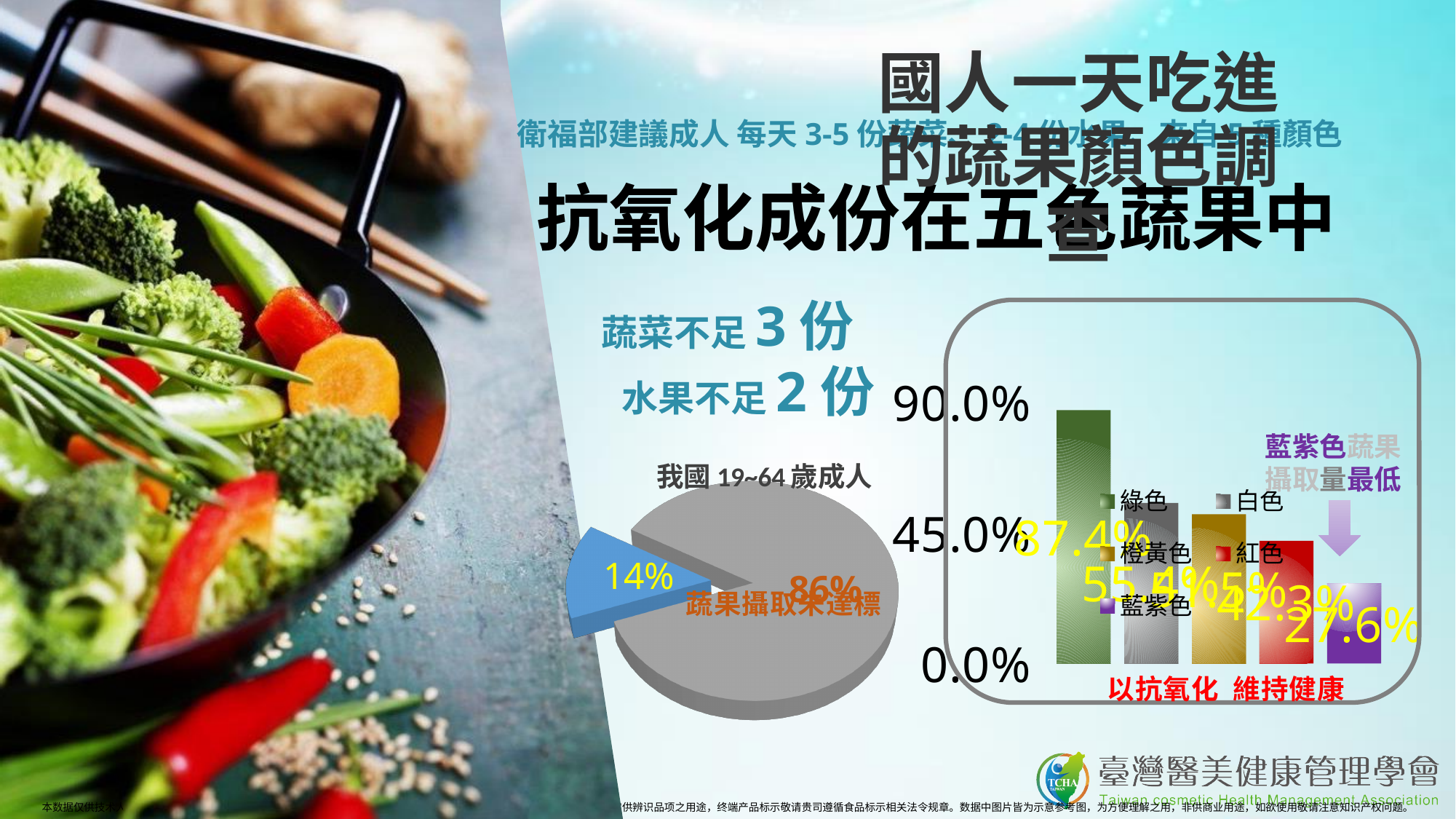
What kind of chart is the chart titled 我國 19~64 歲成人? pie chart In the pie chart titled 我國 19~64 歲成人, what percentage is shown for the large grey slice labelled 蔬果攝取未達標? 86% In the bar chart on the right, which colour category has the lowest value? 藍紫色 How many categories does the legend of the bar chart on the right list? 5 In the bar chart on the right, which colour category has the highest value? 綠色 In the bar chart on the right, is the value for 藍紫色 greater or less than 45.0%? less In the bar chart on the right, what is the value for 紅色? 42.3% In the bar chart on the right, what is the value for 藍紫色? 27.6% In the pie chart titled 我國 19~64 歲成人, what percentage does the blue pulled-out slice show? 14% How many slices does the pie chart titled 我國 19~64 歲成人 have? 2 In the bar chart on the right, what is the value for 綠色? 87.4% In the bar chart on the right, what is the difference between the values for 綠色 and 藍紫色? 59.8%